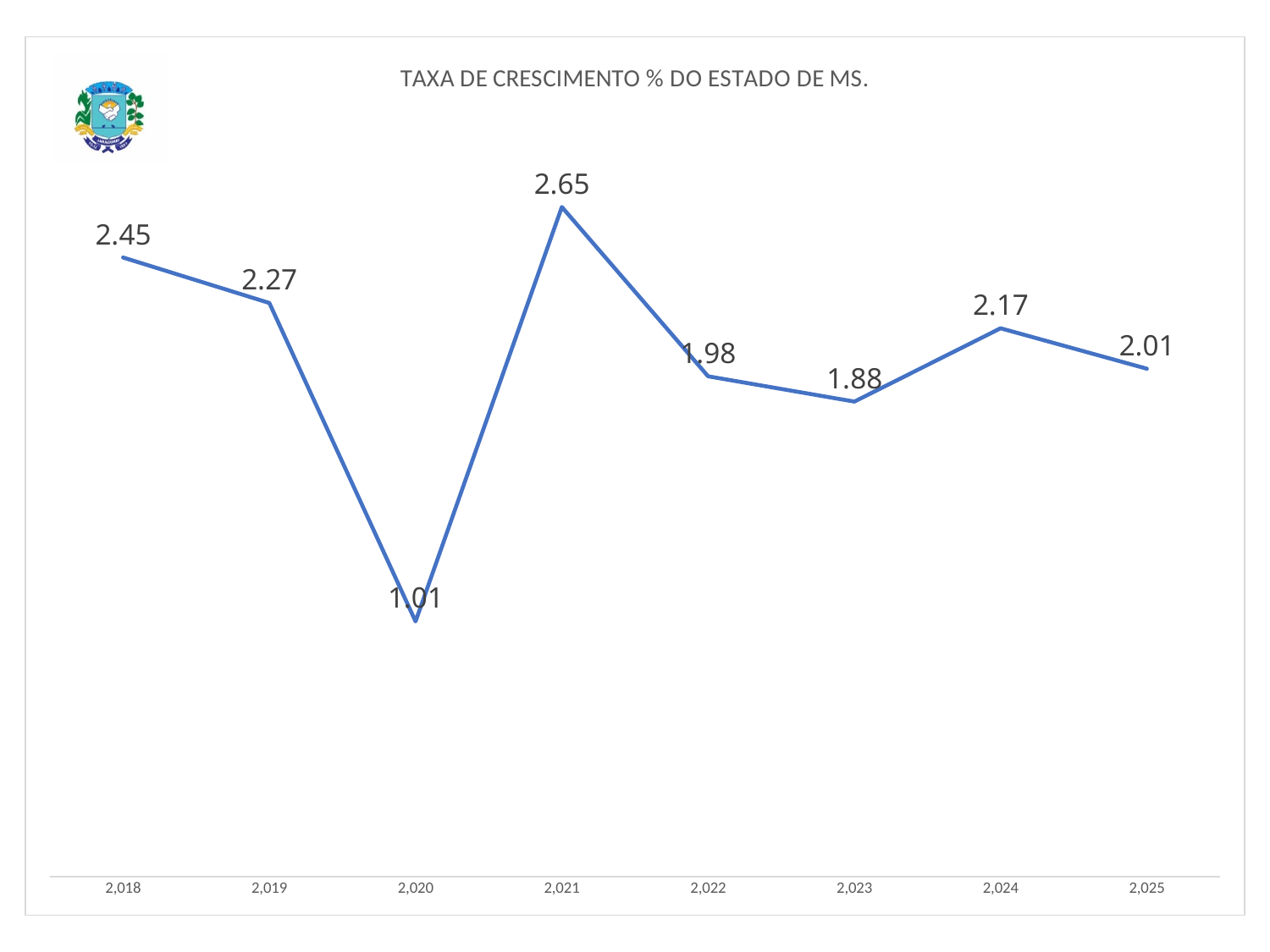
Which is larger, the value for 2,024 or the value for 2,023? 2,024 What kind of chart is shown on the slide? line chart What is the growth rate value for 2,021? 2.65 Which year has the lowest growth rate? 2,020 What is the growth rate value for 2,025? 2.01 What is the difference between the values for 2,018 and 2,019? 0.18 What is the difference between the values for 2,021 and 2,020? 1.64 Which year has the highest growth rate? 2,021 What is the title of the chart? TAXA DE CRESCIMENTO % DO ESTADO DE MS. Do the values rise or fall from 2,018 to 2,020? fall How many years are plotted on the chart? 8 What is the growth rate value for 2,020? 1.01